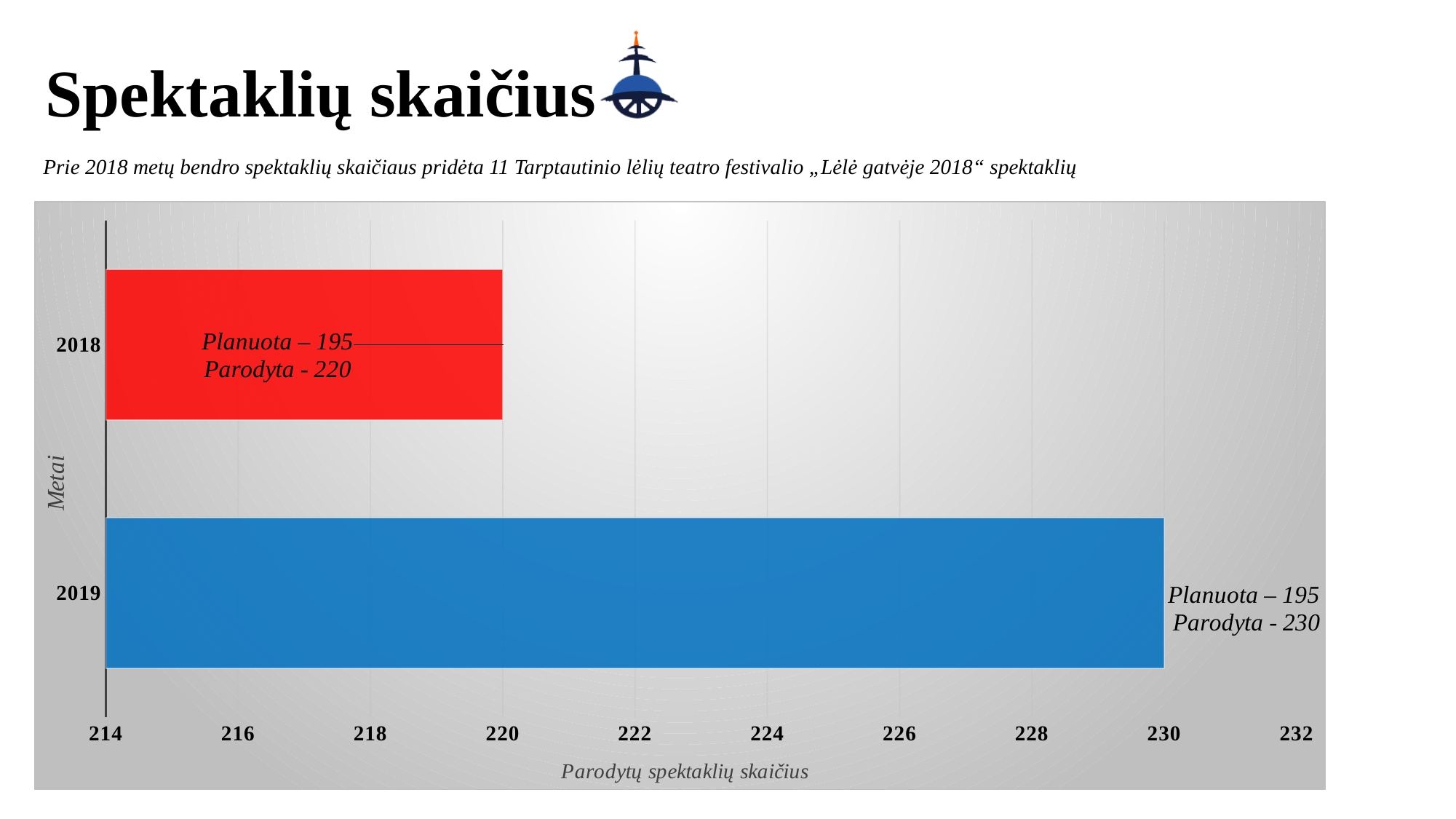
Which year has the lower number of shows performed? 2018 Which year has the higher number of shows performed? 2019 How many years (categories) are shown in the chart? 2 How many shows were planned (Planuota) for 2019? 195 Is the value for 2018 greater or less than 226? less What kind of chart is shown on the slide? bar chart How many shows were planned (Planuota) for 2018? 195 How many shows (Parodyta) were performed in 2018? 220 What is the difference between the number of shows performed in 2019 and in 2018? 10 How many shows (Parodyta) were performed in 2019? 230 What is the label of the horizontal axis? Parodytų spektaklių skaičius What is the title of the slide? Spektaklių skaičius